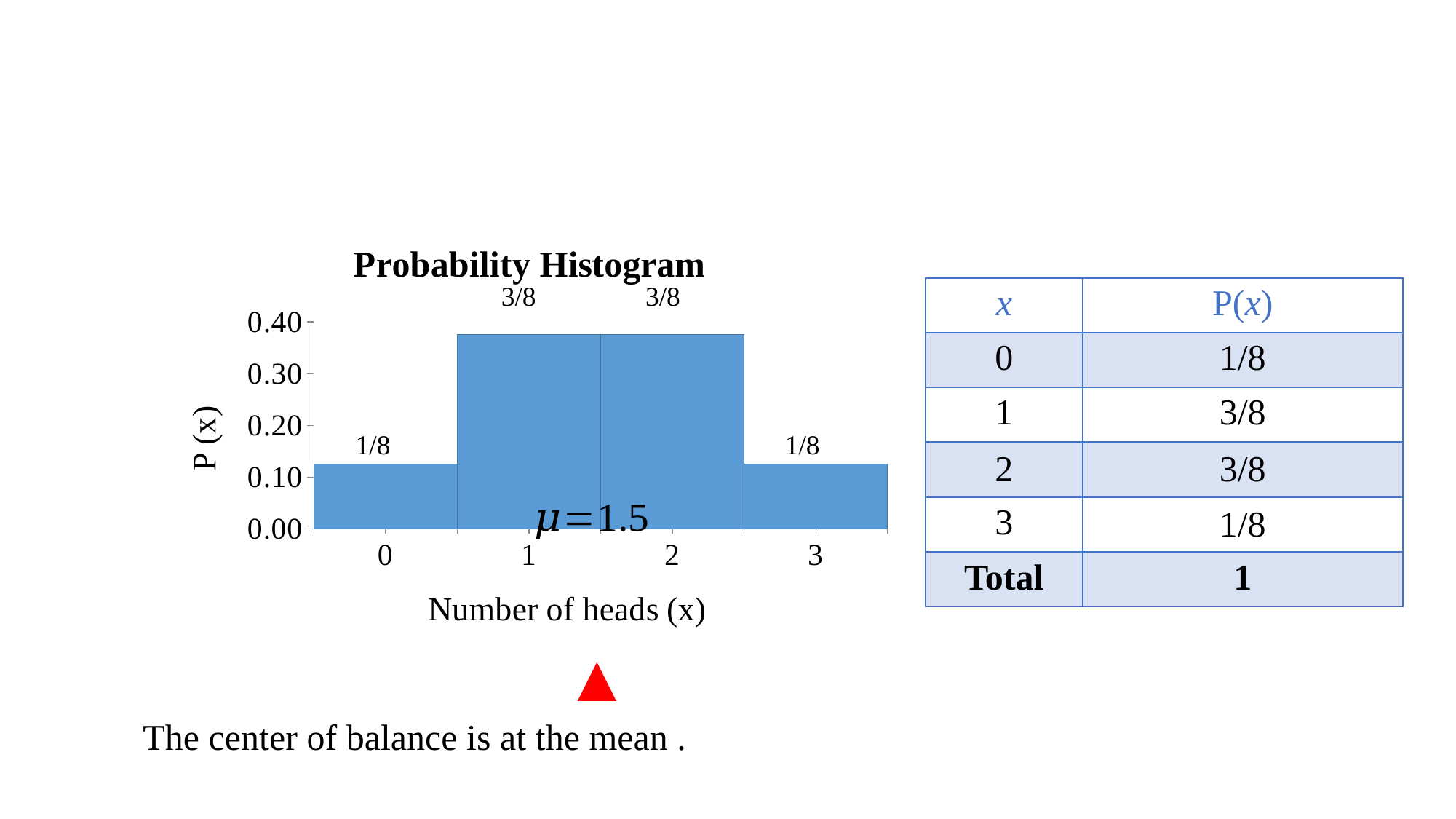
What is the value of the mean (μ) shown on the chart? 1.5 Which is larger, the value for 1 head or the value for 3 heads? 1 head Is the value for 2 heads greater or less than 0.30? greater What is the value of P(x) for 3 heads? 1/8 Is the value for 0 heads greater or less than 0.20? less What is the label of the x axis? Number of heads (x) What is the title of the chart? Probability Histogram What is the value of P(x) for 1 head? 3/8 What is the difference between the value for 2 heads and the value for 3 heads? 2/8 What is the value of P(x) for 0 heads? 1/8 What type of chart is shown on the slide? bar chart How many bars are plotted in the chart? 4